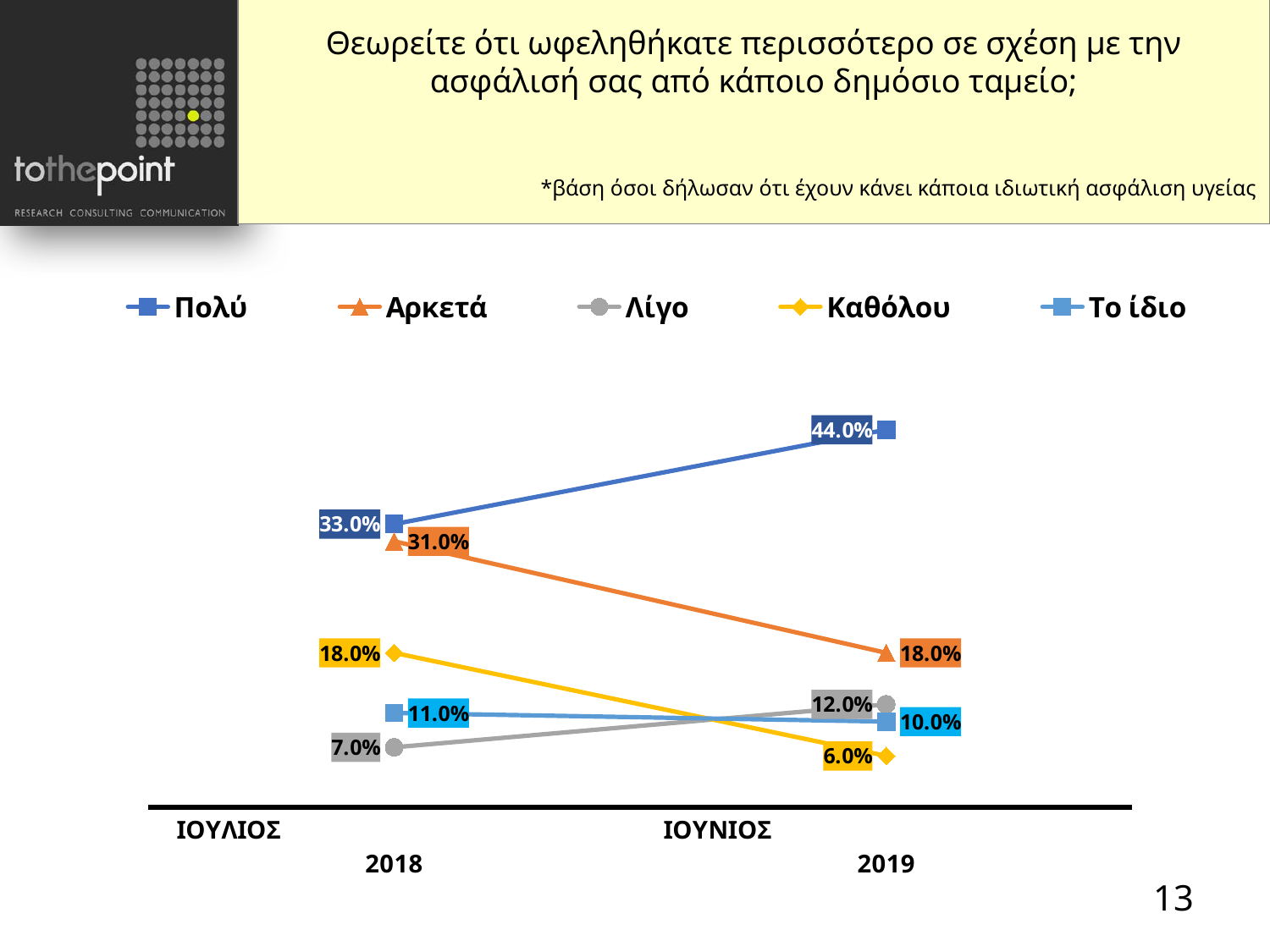
Which series has the lowest value in ΙΟΥΛΙΟΣ 2018? Λίγο By how much did the value for Πολύ change from ΙΟΥΛΙΟΣ 2018 to ΙΟΥΝΙΟΣ 2019? 11.0% What is the value for Πολύ in ΙΟΥΝΙΟΣ 2019? 44.0% Does the value for Αρκετά rise or fall from ΙΟΥΛΙΟΣ 2018 to ΙΟΥΝΙΟΣ 2019? fall What is the value for Αρκετά in ΙΟΥΛΙΟΣ 2018? 31.0% Which series has the highest value in ΙΟΥΝΙΟΣ 2019? Πολύ What is the value for Καθόλου in ΙΟΥΝΙΟΣ 2019? 6.0% Which is larger in ΙΟΥΝΙΟΣ 2019, the value for Λίγο or the value for Το ίδιο? Λίγο How many time points are plotted along the x axis? 2 How many series does the legend list? 5 What kind of chart is shown on the slide? line chart What is the value for Λίγο in ΙΟΥΛΙΟΣ 2018? 7.0%